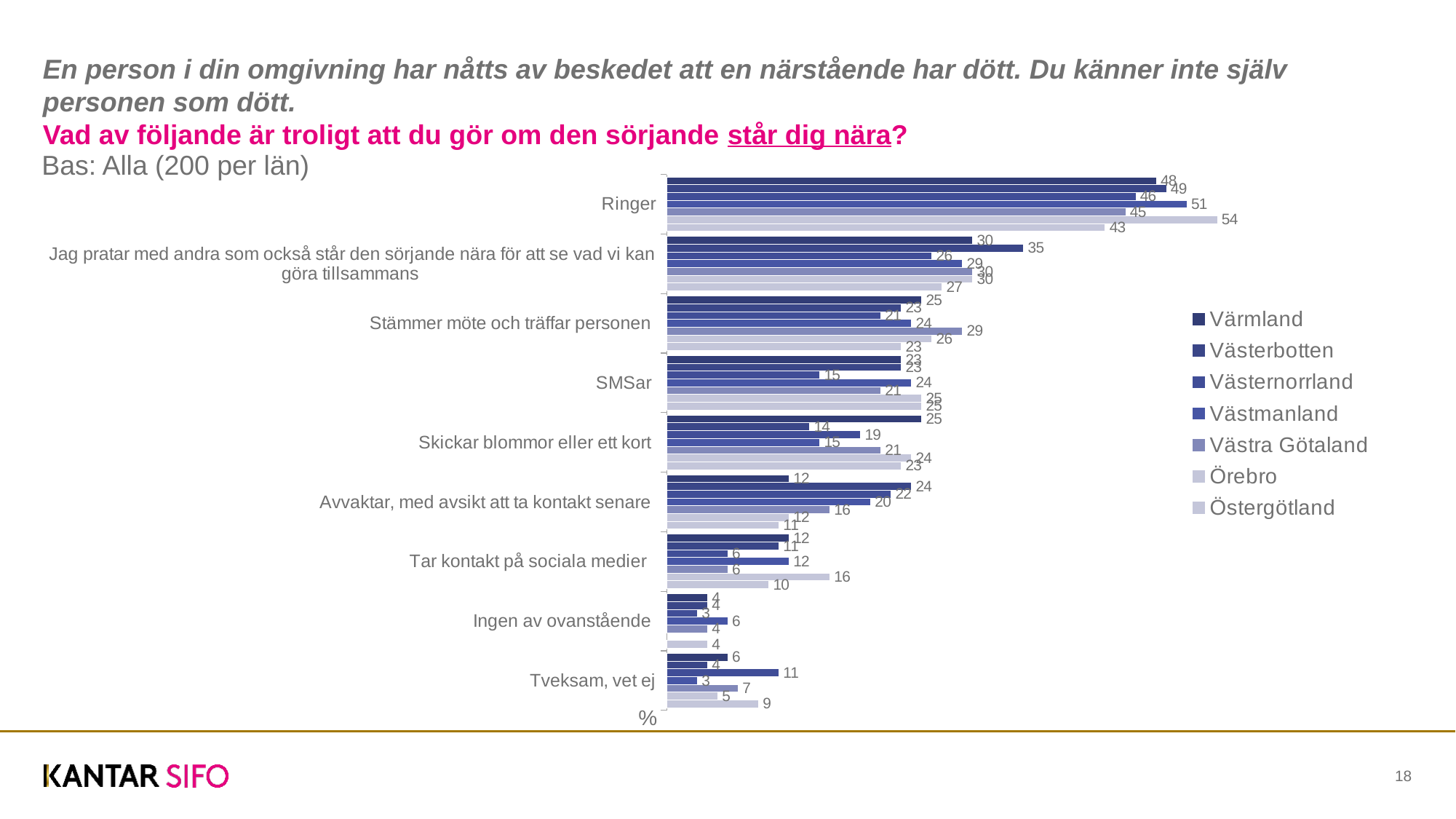
What kind of chart is shown on the slide? bar chart What is the difference between Östergötland and Örebro in the category 'Ringer'? 11 Which region is listed first in the legend? Värmland What is the value for Västerbotten in the category 'Jag pratar med andra som också står den sörjande nära för att se vad vi kan göra tillsammans'? 35 What is the value for Västra Götaland in the category 'Stämmer möte och träffar personen'? 29 In the category 'Avvaktar, med avsikt att ta kontakt senare', which is larger: Västerbotten or Värmland? Västerbotten How many series (regions) does the legend list? 7 Which region has the highest value for 'Ringer'? Örebro Which region has the lowest value for 'SMSar'? Västernorrland How many response categories are plotted on the chart? 9 What is the value for Östergötland in the category 'Ringer'? 43 What is the value for Västernorrland in the category 'Tveksam, vet ej'? 11